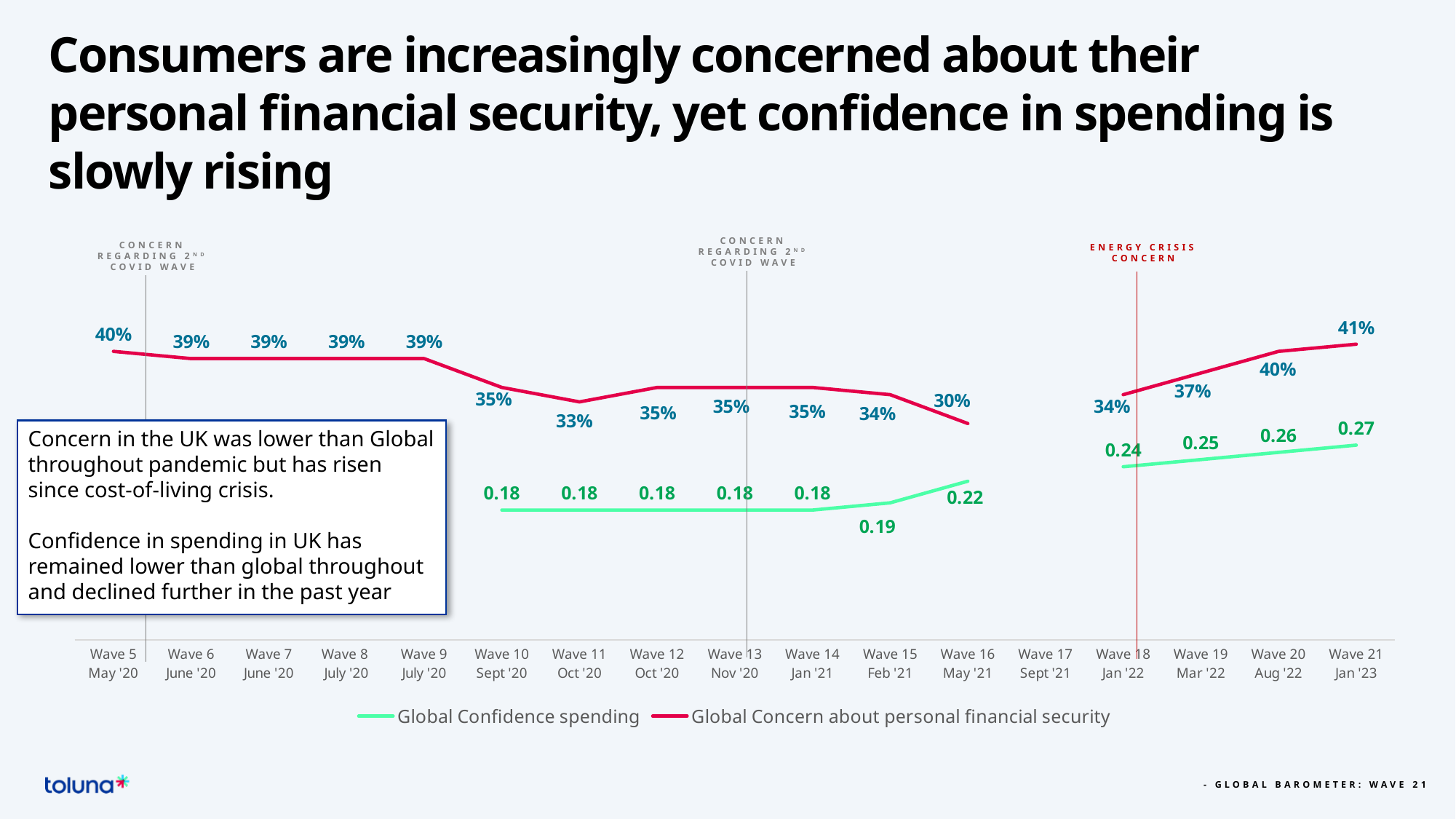
How many waves are labelled on the x axis? 17 What kind of chart is shown on the slide? Line chart What is the difference in Global Confidence spending between Wave 21 and Wave 10? 0.09 What is the value of Global Concern about personal financial security at Wave 21 (Jan '23)? 41% How many series does the legend list? 2 Does Global Confidence spending rise or fall from Wave 18 to Wave 21? Rises What is the value of Global Concern about personal financial security at Wave 11 (Oct '20)? 33% By how many percentage points did Global Concern about personal financial security rise from Wave 16 to Wave 21? 11 percentage points At which wave is Global Concern about personal financial security lowest? Wave 16 (May '21), 30% At which wave is Global Concern about personal financial security highest? Wave 21 (Jan '23), 41% What is the value of Global Confidence spending at Wave 18 (Jan '22)? 0.24 Which wave has a higher Global Concern about personal financial security value, Wave 19 or Wave 20? Wave 20